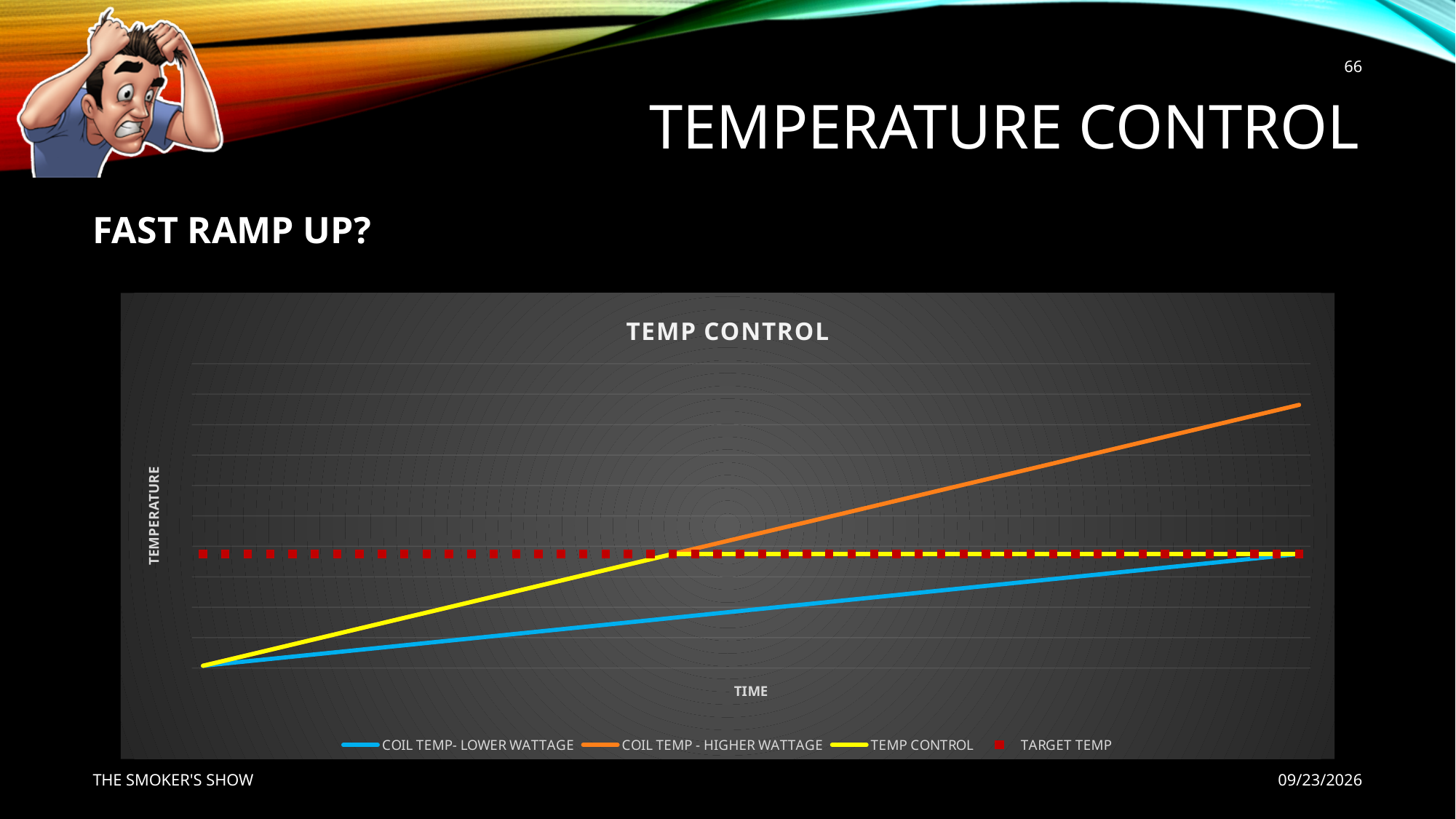
Does the TARGET TEMP series rise, fall, or stay flat along the time axis? stay flat What kind of chart is shown on the slide? line chart Does the COIL TEMP- LOWER WATTAGE series rise or fall along the time axis? rise Which series rises at first and then stays flat at the target temperature? TEMP CONTROL How many series does the chart legend list? 4 What is the title of the chart? TEMP CONTROL What is the label of the horizontal axis of the chart? TIME Which series is plotted as a dashed line of red squares? TARGET TEMP Which series reaches the highest temperature at the right end of the chart? COIL TEMP - HIGHER WATTAGE At the right end of the chart, which is higher: COIL TEMP - HIGHER WATTAGE or COIL TEMP- LOWER WATTAGE? COIL TEMP - HIGHER WATTAGE